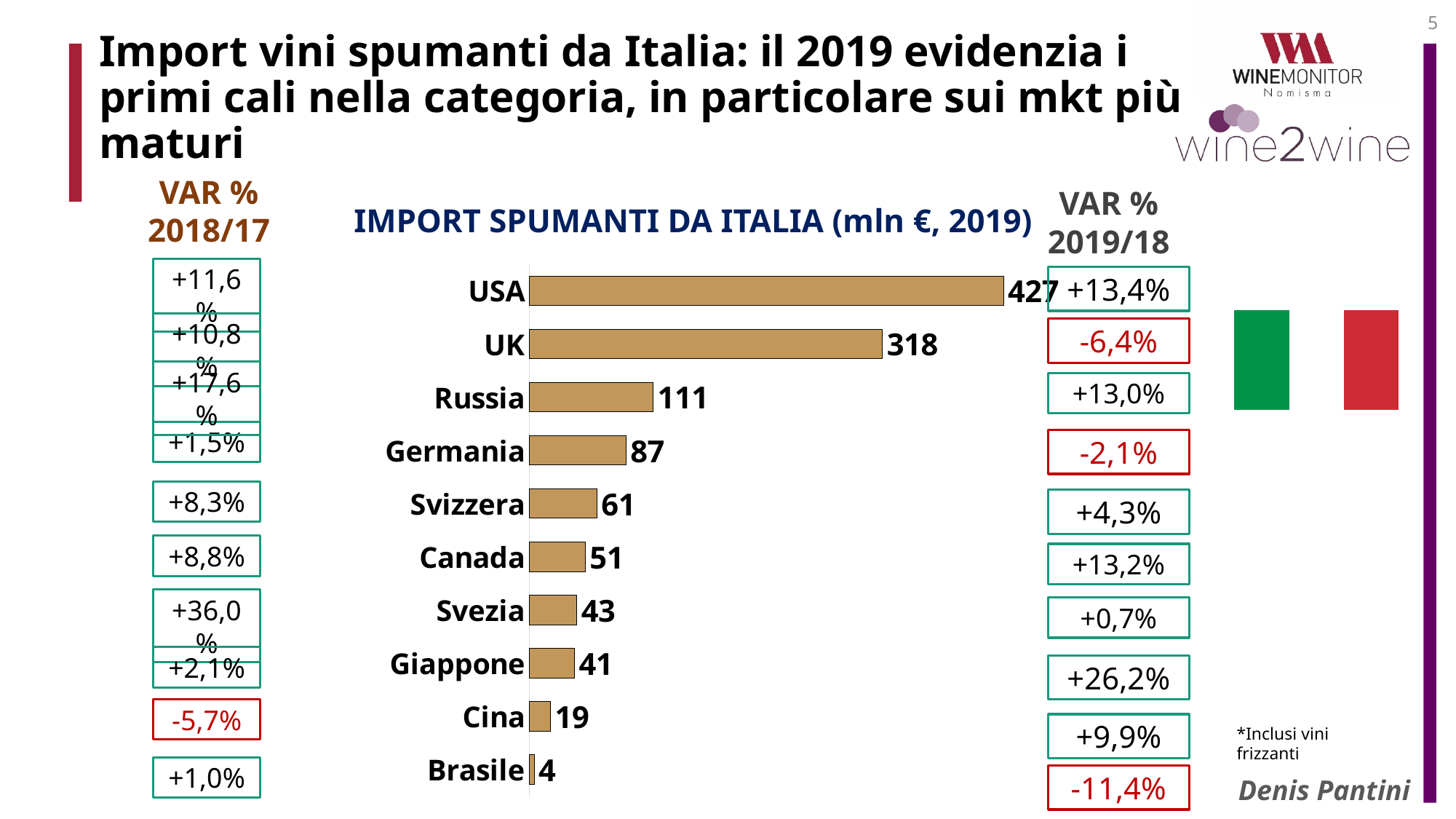
What kind of chart is shown on the slide? Bar chart Which country has the highest import value in the chart? USA Which country has the lowest import value in the chart? Brasile What is the value for Svezia in the chart? 43 What is the difference between the values for Germania and Svizzera? 26 What is the difference between the values for USA and UK? 109 What is the value for Russia in the chart? 111 What is the title of the chart? IMPORT SPUMANTI DA ITALIA (mln €, 2019) What is the value for USA in the chart 'IMPORT SPUMANTI DA ITALIA (mln €, 2019)'? 427 What is the VAR % 2019/18 shown next to the UK bar? -6,4% How many countries are shown in the chart? 10 Which is larger, the value for Canada or the value for Giappone? Canada